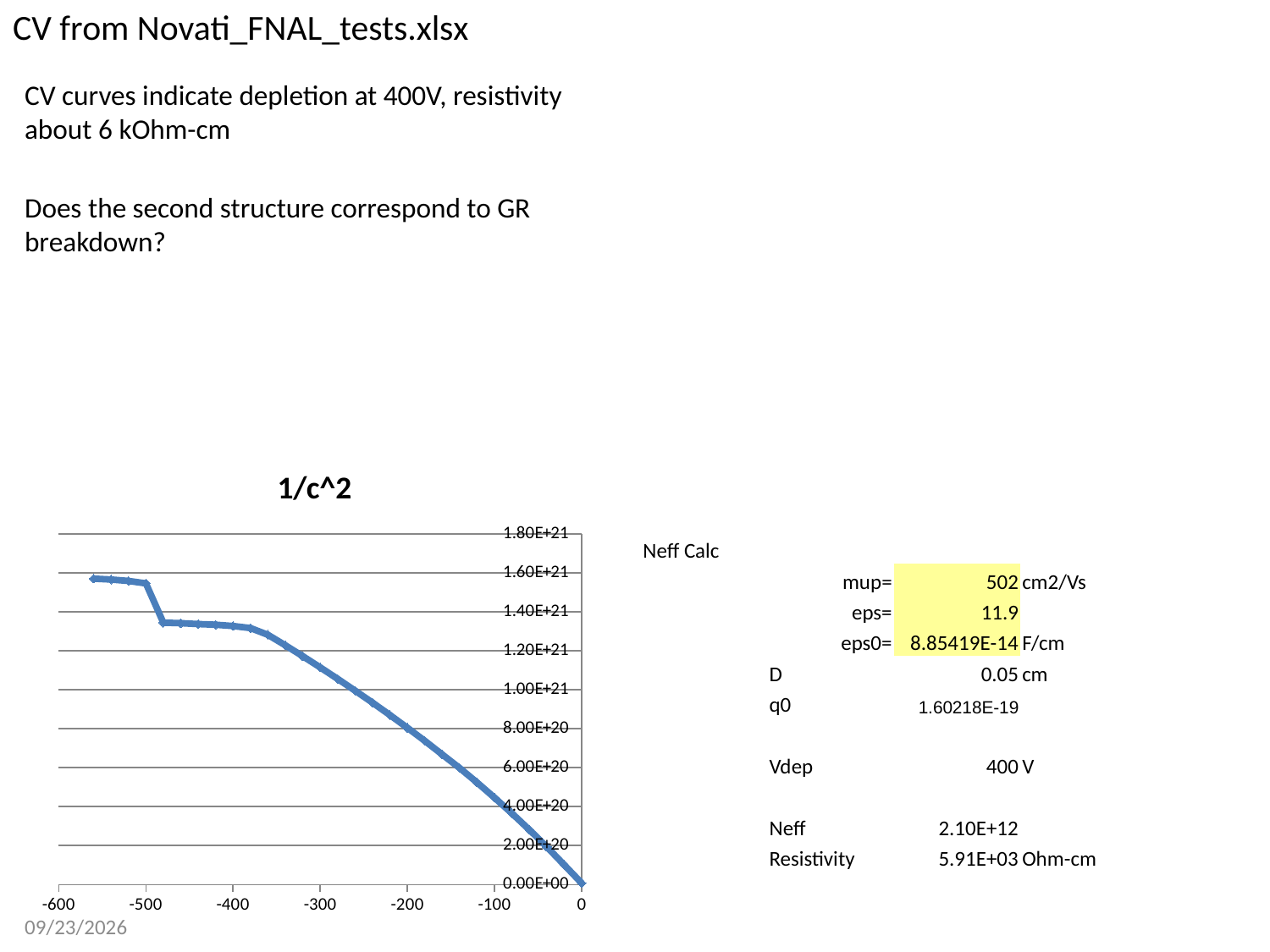
Is the value of 1/c^2 at x = -50 greater or less than 4.00E+20? less Which is larger, the value of 1/c^2 at x = -200 or at x = -100? x = -200 What kind of chart is shown on the slide? line chart Is the value of 1/c^2 at x = -300 greater or less than 1.00E+21? greater Is the value of 1/c^2 at x = -450 greater or less than 1.20E+21? greater What is the title of the chart? 1/c^2 Which is larger, the value of 1/c^2 at x = -550 or at x = -450? x = -550 As x increases from -600 toward 0, do the 1/c^2 values rise or fall overall? fall What is the highest value shown on the chart's y axis? 1.80E+21